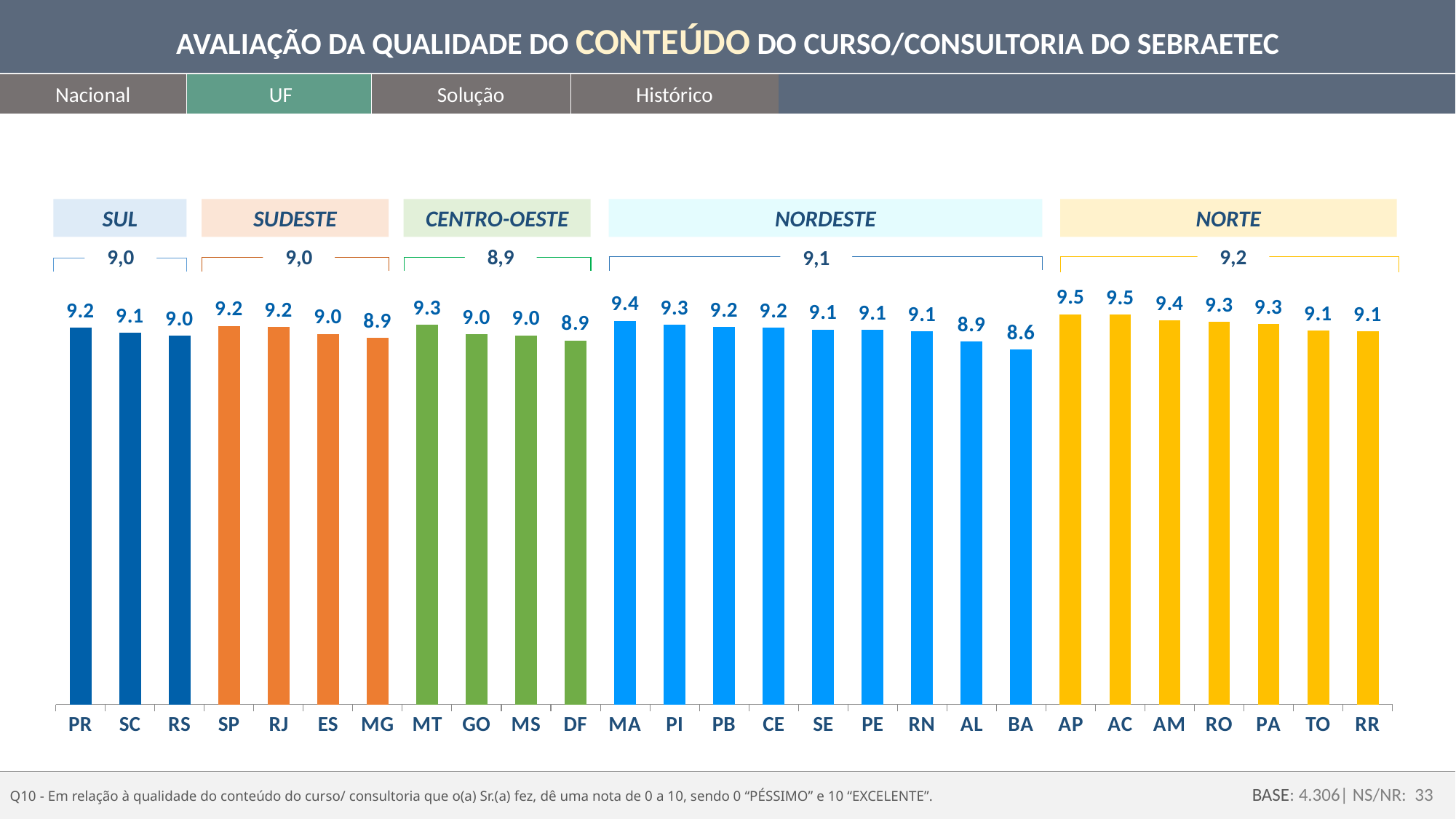
What is the value for MA? 9.4 Which region has the lowest average value shown above its group? CENTRO-OESTE Which is larger, the value for MT or the value for DF? MT What is the value for MT? 9.3 What is the average value shown for the NORTE region? 9,2 What is the difference between the values for MA and BA? 0.8 How many regional groups are the bars divided into? 5 Within the NORDESTE group, do the values rise or fall from MA to BA? Fall What is the value for BA? 8.6 How many states (bars) are shown in the chart? 27 What kind of chart is shown on the slide? Bar chart Which state has the lowest value? BA